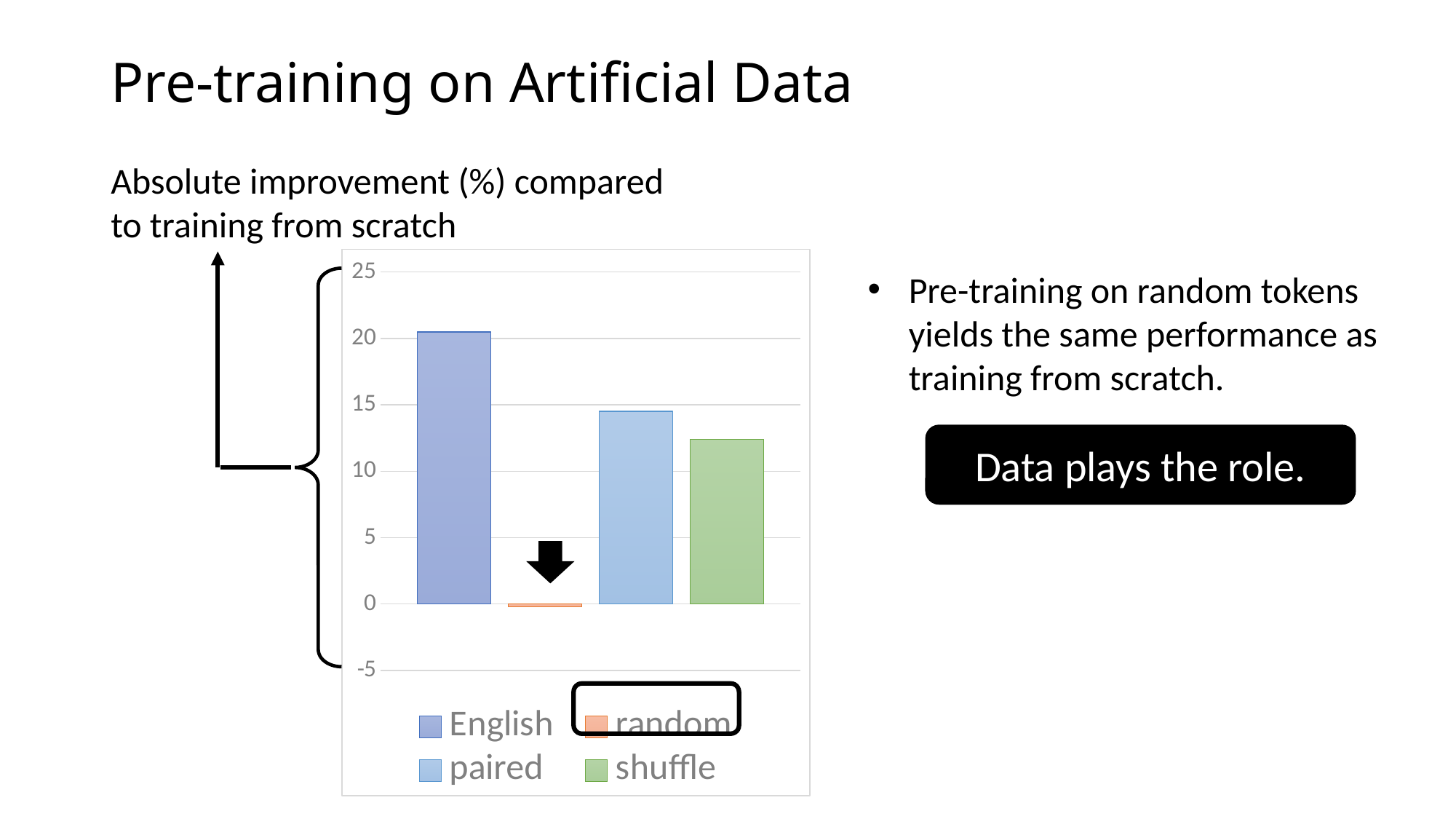
What kind of chart is shown on the slide? bar chart Which is larger, the value for English or the value for paired? English Is the value for random greater or less than 5? less Which is larger, the value for paired or the value for shuffle? paired Is the value for shuffle greater or less than 10? greater How many bars are plotted in the chart? 4 Is the value for English greater or less than 15? greater Which series has the highest absolute improvement? English How many series does the legend list? 4 Which series has the lowest absolute improvement? random Which legend entry is highlighted with a black rounded outline? random